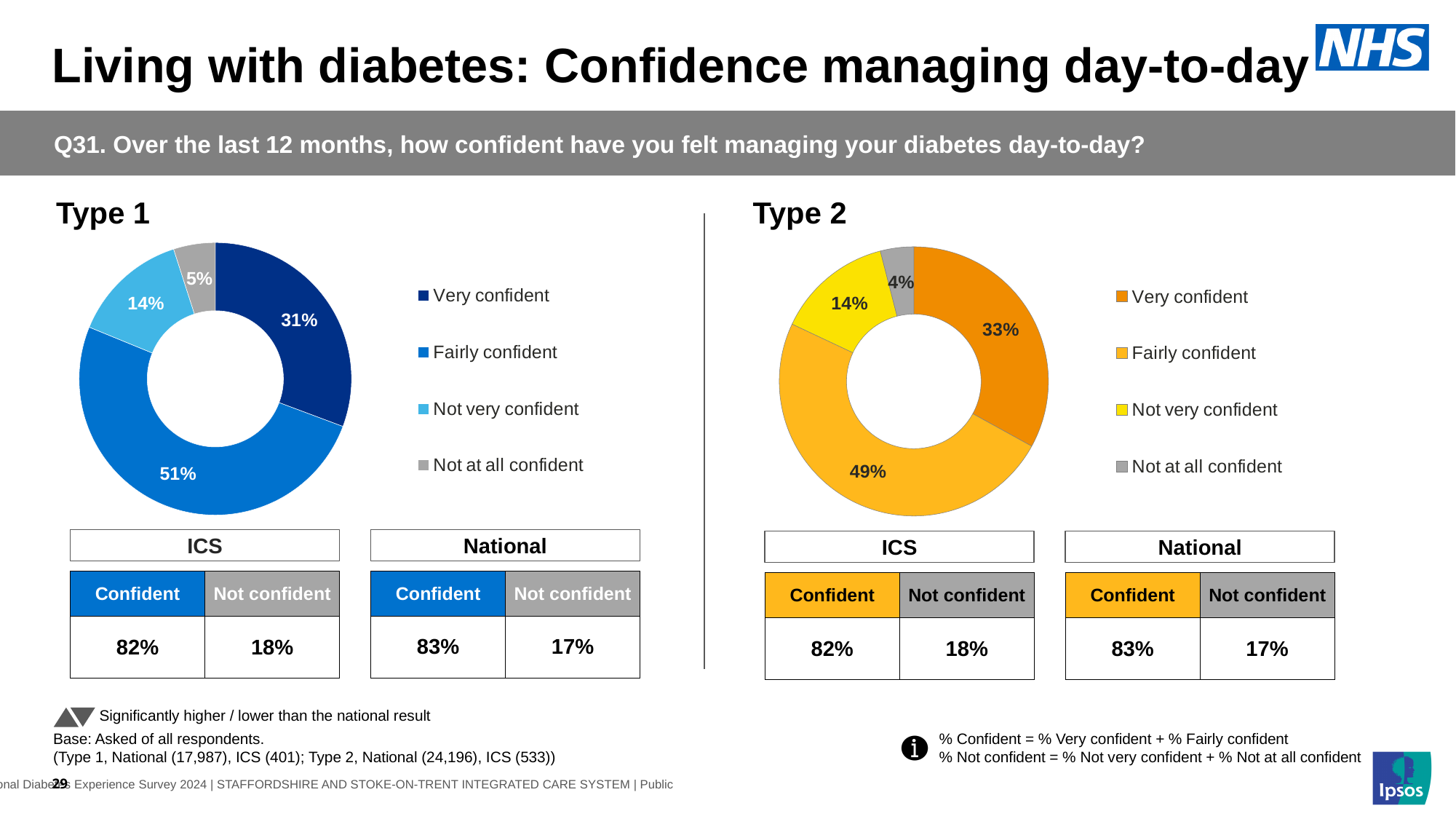
In the Type 1 chart, which category has the largest share? Fairly confident In the Type 1 chart, what percentage of respondents were Fairly confident? 51% Is the Very confident share larger in the Type 1 chart or the Type 2 chart? Type 2 In the Type 1 chart, what is the difference between the Fairly confident and Very confident shares? 20 percentage points In the Type 2 chart, what percentage of respondents were Not at all confident? 4% How many categories does the Type 1 chart show? 4 In the Type 2 chart, what is the difference between the Very confident and Not very confident shares? 19 percentage points In the Type 1 chart, what percentage of respondents were Very confident? 31% What kind of chart is used for Type 2? Doughnut (pie) chart In the Type 2 chart, what percentage of respondents were Not very confident? 14% In the Type 1 chart, what colour represents Not very confident? Light blue In the Type 2 chart, which category has the smallest share? Not at all confident